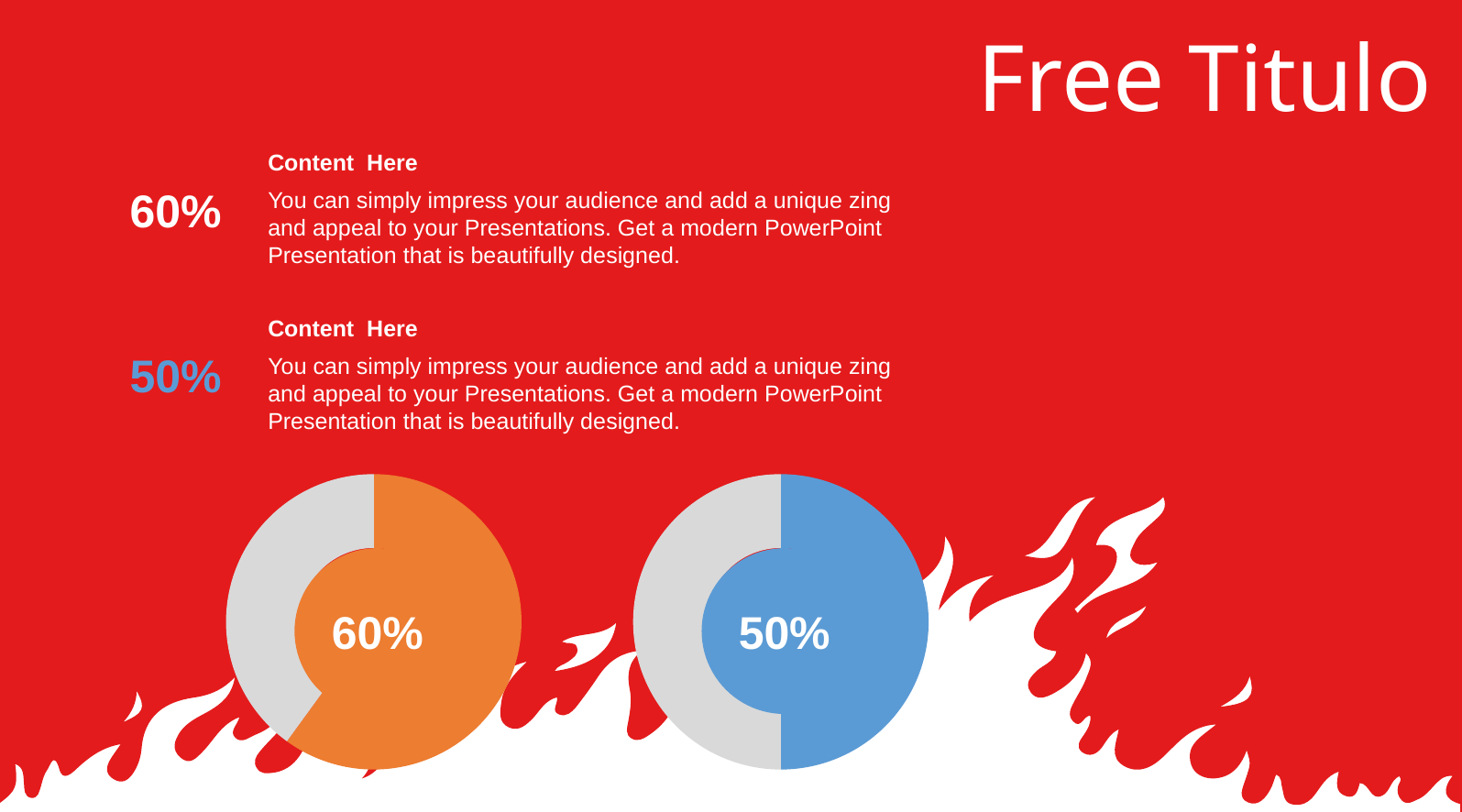
What is the difference between the percentage shown in the left chart and the percentage shown in the right chart? 10% What colour is the filled portion of the right doughnut chart? blue Which chart shows the larger percentage, the left (orange) chart or the right (blue) chart? the left (orange) chart Is the value shown in the right (blue) doughnut chart greater or less than 60%? less What kind of chart is the right chart on the slide? doughnut chart What percentage is shown in the centre of the left (orange) doughnut chart? 60% How many doughnut charts are on the slide? 2 What share of the left doughnut chart is filled in orange? 60% What kind of chart is the left chart on the slide? doughnut chart What colour is the filled portion of the left doughnut chart? orange What share of the right doughnut chart is filled in blue? 50% What percentage is shown in the centre of the right (blue) doughnut chart? 50%